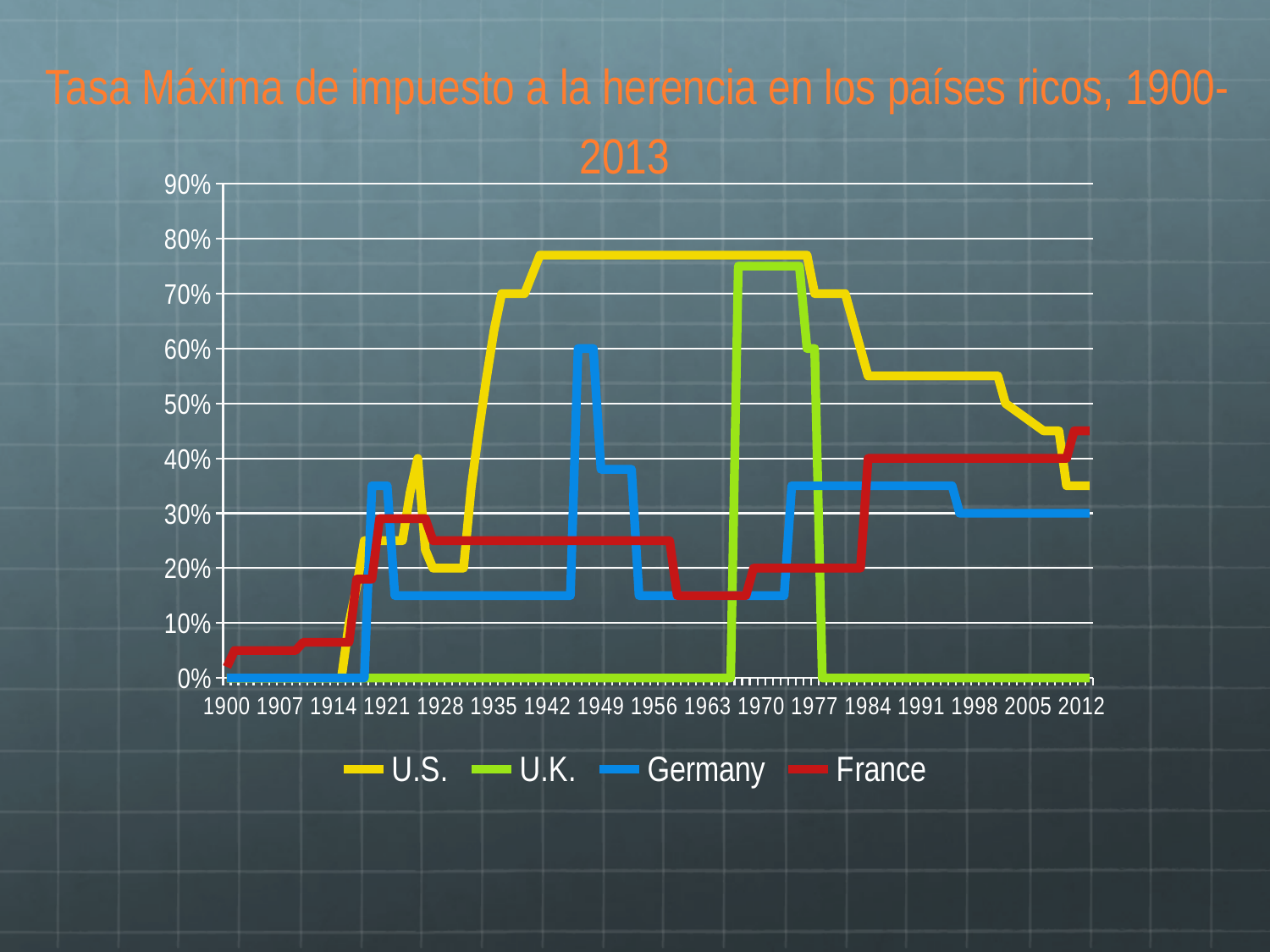
Is the value for France in 1900 greater or less than 10%? less Is the value for France in 1963 greater or less than 20%? less Is the value for the U.S. in 1949 greater or less than 70%? greater In 1949, which is larger: the value for the U.S. or the value for Germany? U.S. How many series does the legend list? 4 Does the U.S. line rise or fall between 1949 and 2012? fall Which countries are listed in the chart legend? U.S., U.K., Germany, France How many year labels are shown on the x axis? 17 What is the title of the chart? Tasa Máxima de impuesto a la herencia en los países ricos, 1900-2013 What kind of chart is shown on the slide? line chart